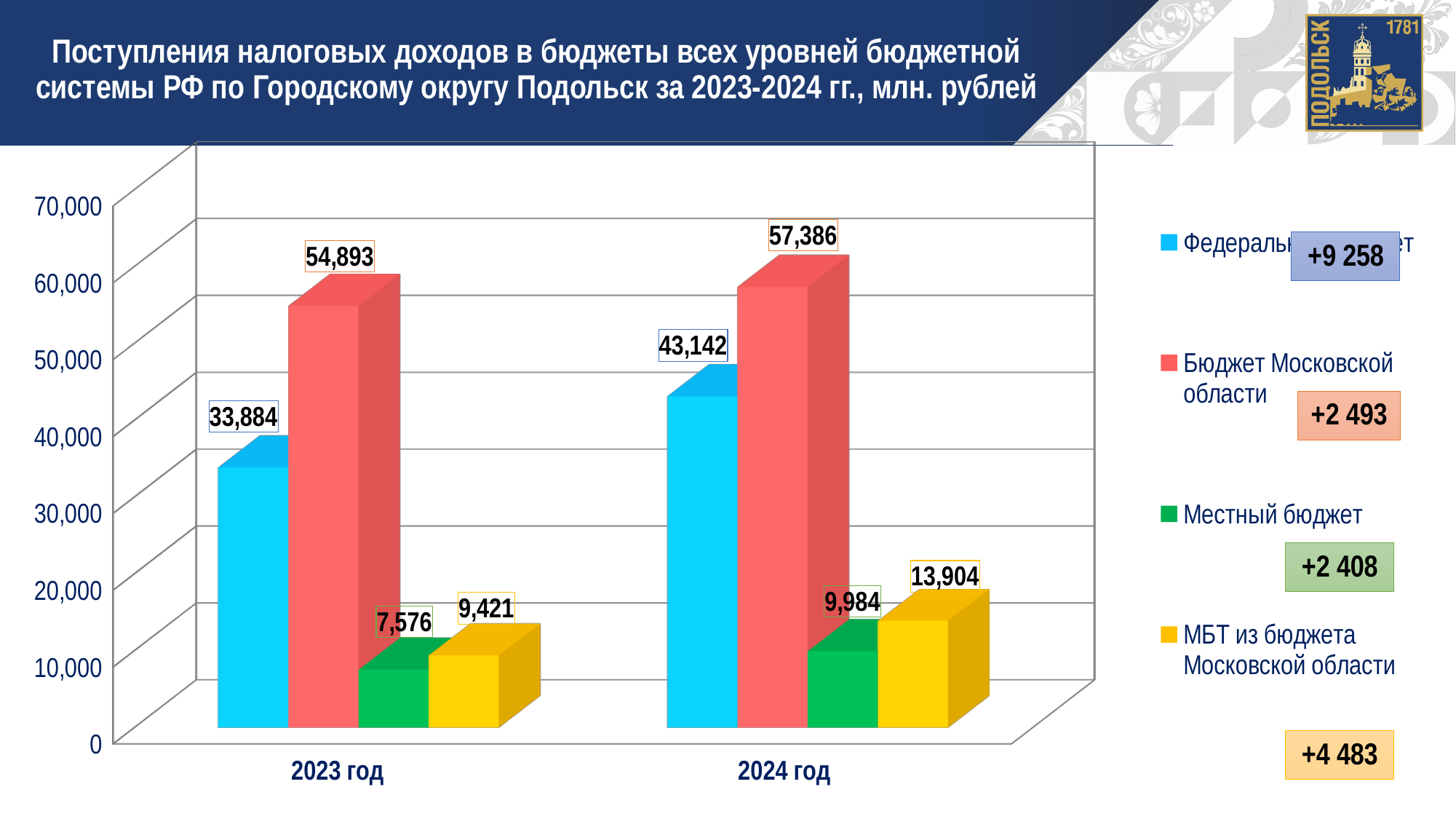
How many series does the legend list? 4 Which series has the lowest value in 2023 год? Местный бюджет What is the value for МБТ из бюджета Московской области in 2024 год? 13,904 What type of chart is shown on the slide? Bar chart By how much did Бюджет Московской области increase from 2023 год to 2024 год? 2,493 Does the value for Местный бюджет rise or fall from 2023 год to 2024 год? Rise What is the value for Местный бюджет in 2023 год? 7,576 Which series has the highest value in 2024 год? Бюджет Московской области What is the value of the light blue (first legend) series in 2024 год? 43,142 How many year categories are shown on the x axis? 2 What is the value for Бюджет Московской области in 2024 год? 57,386 What is the value for Бюджет Московской области in 2023 год? 54,893